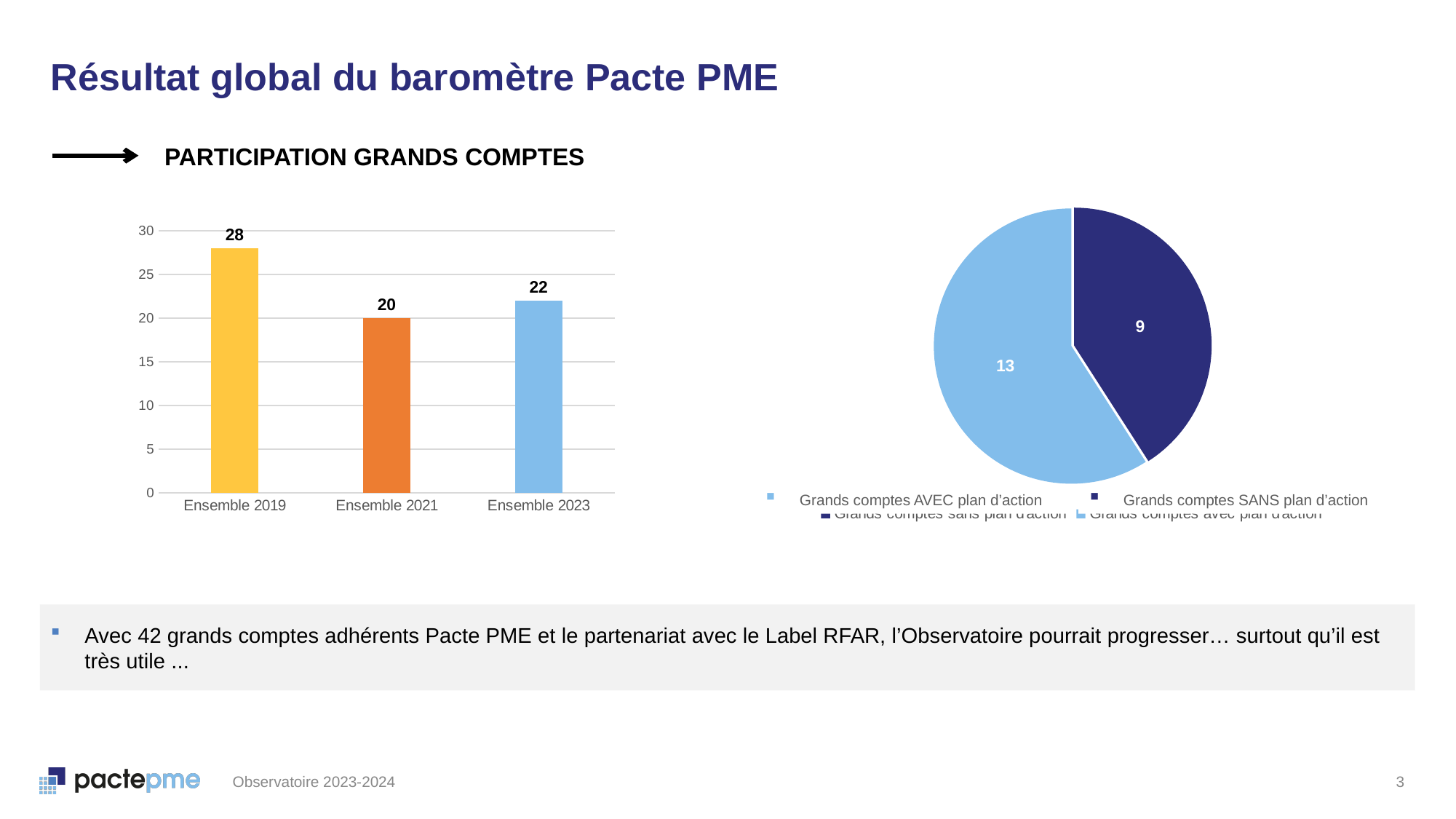
In the bar chart on the left, what is the value for Ensemble 2019? 28 In the bar chart on the left, what is the value for Ensemble 2021? 20 In the pie chart on the right, what is the value for Grands comptes SANS plan d'action? 9 In the pie chart on the right, what is the total of the two slices? 22 In the pie chart on the right, what is the value for Grands comptes AVEC plan d'action? 13 In the bar chart on the left, what is the difference between the values for Ensemble 2019 and Ensemble 2023? 6 In the bar chart on the left, which is larger, the value for Ensemble 2021 or Ensemble 2023? Ensemble 2023 What kind of chart is the chart on the left of the slide? Bar chart In the bar chart on the left, which category has the lowest value? Ensemble 2021 In the bar chart on the left, which category has the highest value? Ensemble 2019 In the bar chart on the left, what is the value for Ensemble 2023? 22 In the bar chart on the left, how many categories are shown on the x axis? 3